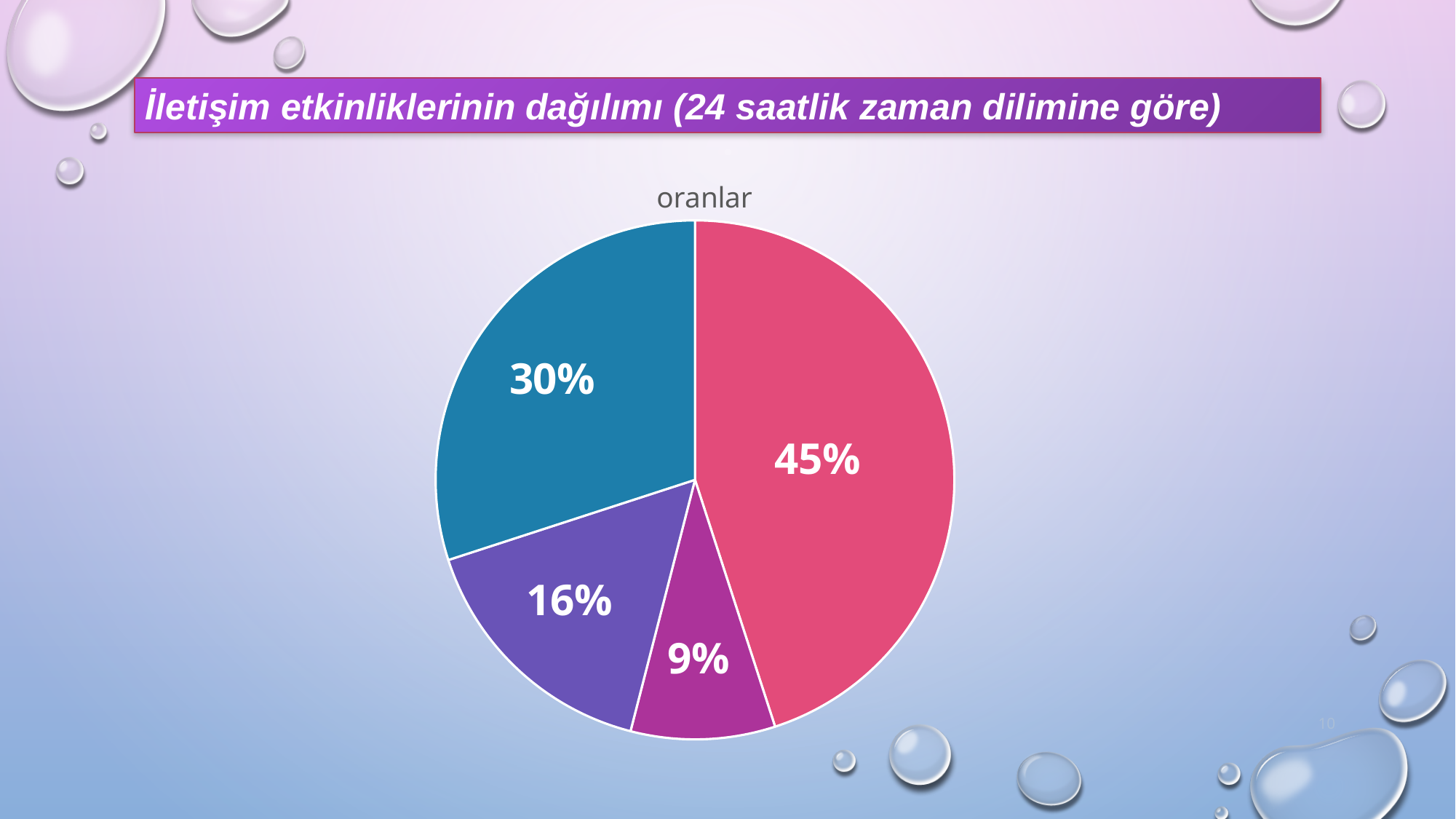
What percentage is shown on the pink (red) slice of the pie chart? 45% What is the difference between the largest slice (45%) and the smallest slice (9%)? 36% What is the title of the chart? oranlar What is the difference between the 30% slice and the 16% slice? 14% What percentage is shown on the purple slice of the pie chart? 16% Which slice is larger, the teal slice or the purple slice? the teal slice How many slices does the pie chart have? 4 What colour is the slice labelled 9%? magenta What percentage is shown on the teal (blue) slice of the pie chart? 30% What is the value shown on the largest slice of the pie chart? 45% What is the value shown on the smallest slice of the pie chart? 9% What kind of chart is shown on the slide? pie chart